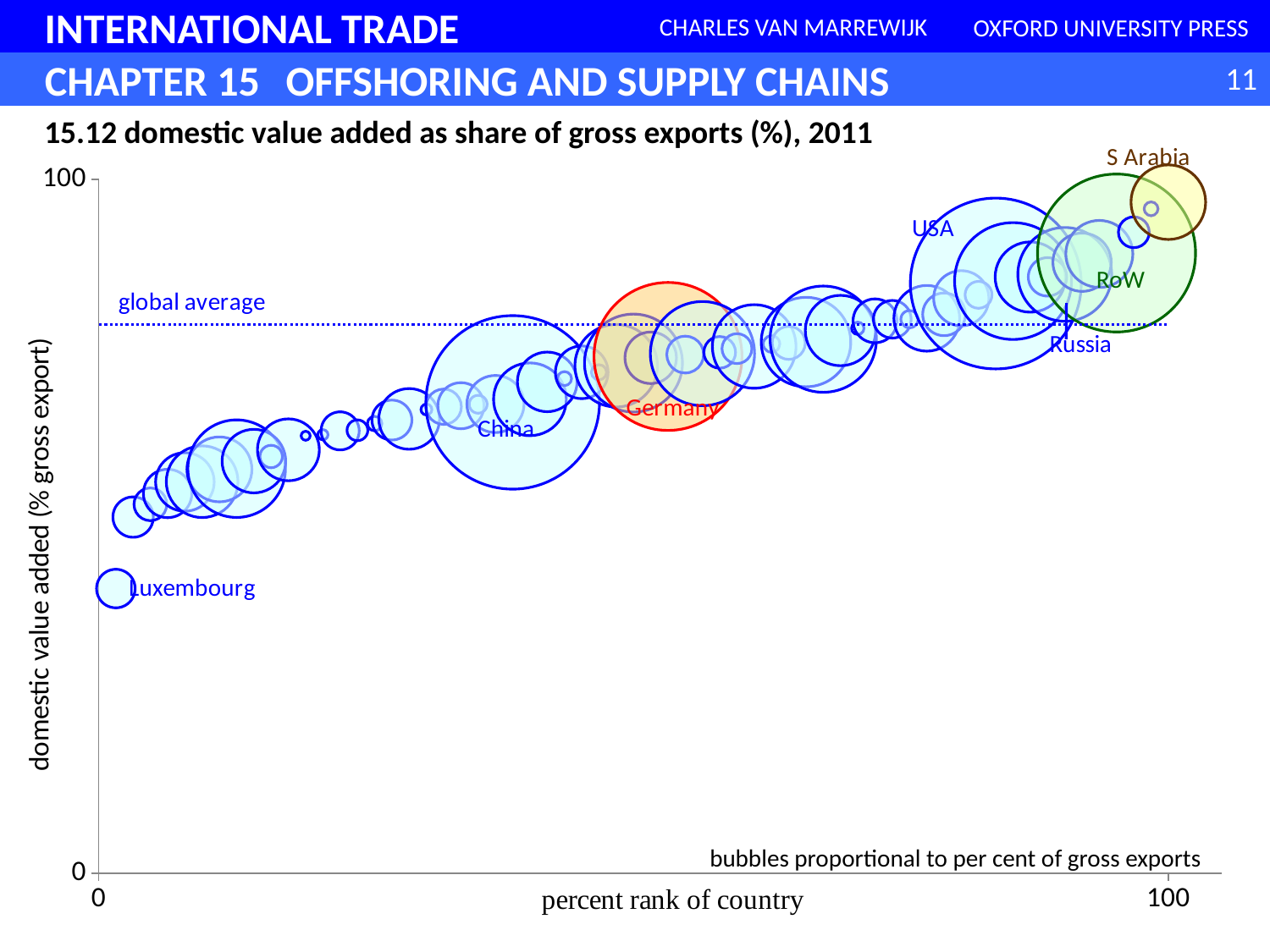
Do the values rise or fall as the percent rank of country increases along the x axis? Rise Which has a higher domestic value added share, USA or Luxembourg? USA What is the value at the top tick of the y axis? 100 What does the x axis of the chart represent? percent rank of country What is the title of the chart? 15.12 domestic value added as share of gross exports (%), 2011 Is Germany's domestic value added share above or below the global average line? Below Which labelled country has the highest domestic value added as a share of gross exports? S Arabia Which has a higher domestic value added share, Germany or China? Germany Which labelled country has the lowest domestic value added as a share of gross exports? Luxembourg What kind of chart is shown on the slide? Bubble chart